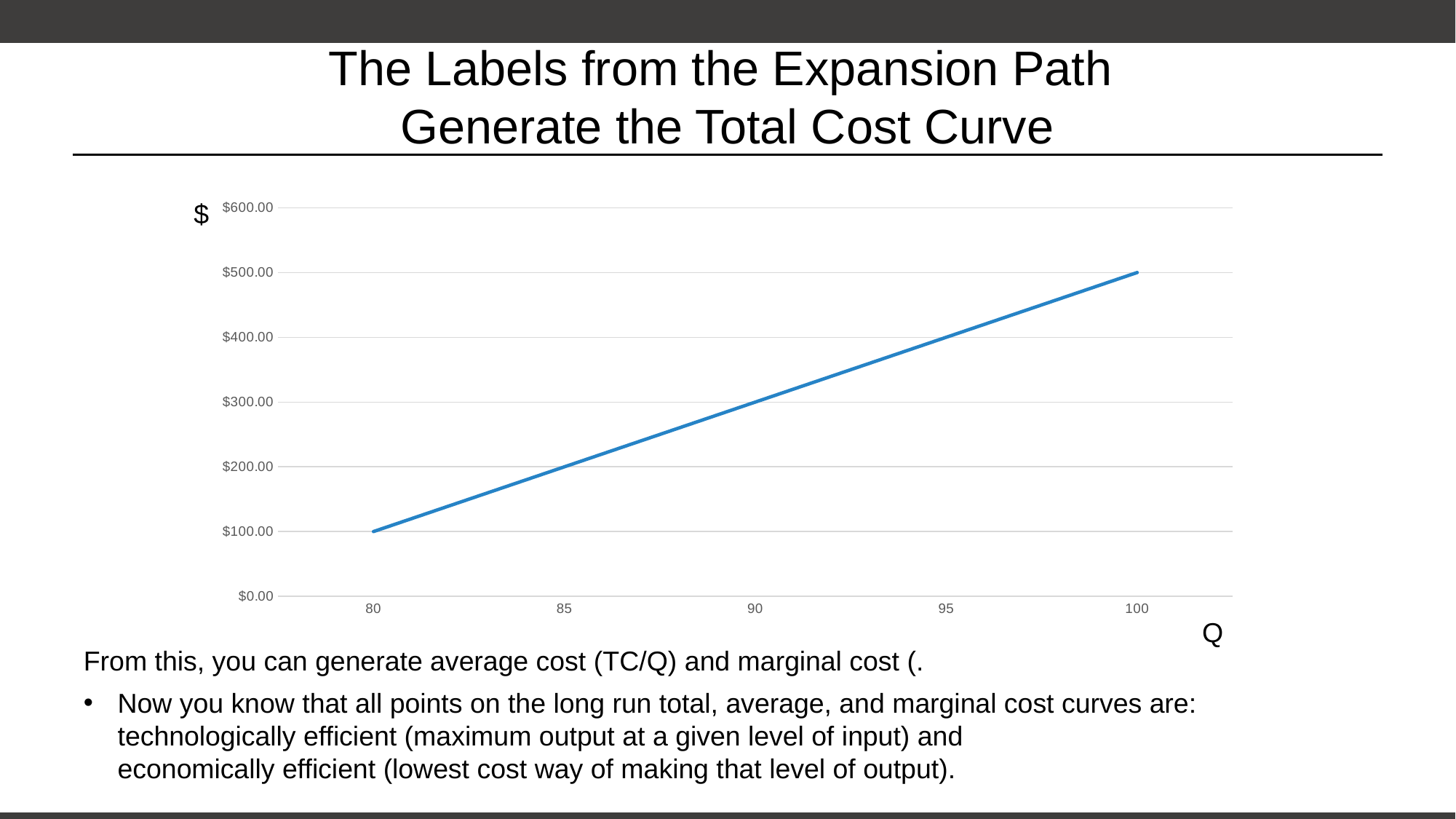
What is the value of the line at Q = 90? $300.00 What label is shown on the vertical axis of the chart? $ How many tick labels are shown on the x axis? 5 What kind of chart is shown on the slide? line chart At which Q value on the x axis is the line at its lowest value? 80 What is the difference between the value at Q = 100 and the value at Q = 80? $400.00 Is the value at Q = 95 greater or less than $300.00? greater Do the values on the chart rise or fall as Q increases from 80 to 100? rise At which Q value on the x axis does the line reach its highest value? 100 What is the value of the line at Q = 80? $100.00 Which is larger, the value at Q = 85 or the value at Q = 95? Q = 95 What is the value of the line at Q = 100? $500.00